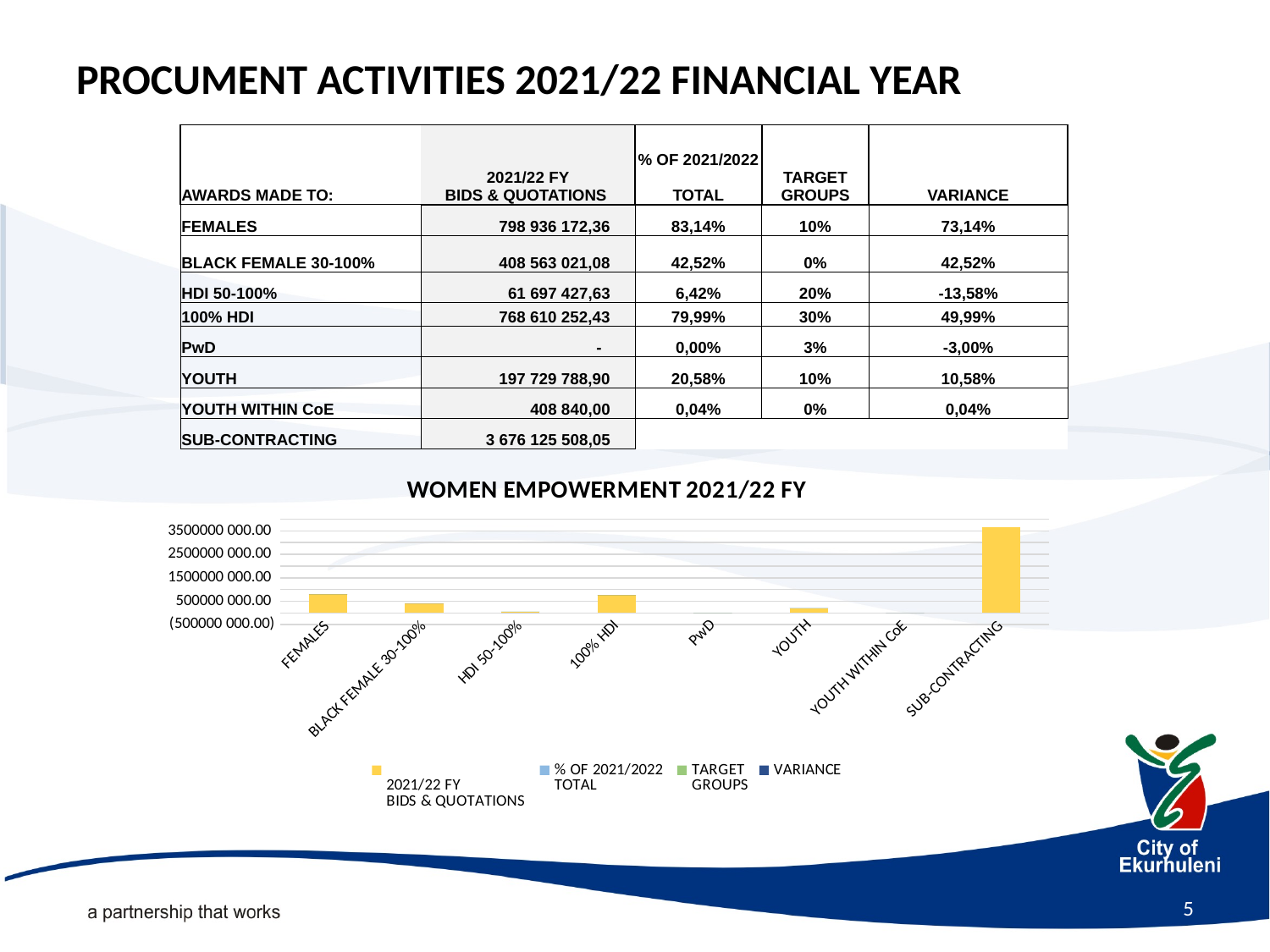
What kind of chart is shown under the title WOMEN EMPOWERMENT 2021/22 FY? Bar chart How many series does the legend of the WOMEN EMPOWERMENT 2021/22 FY chart list? 4 In the WOMEN EMPOWERMENT 2021/22 FY chart, which category has the tallest bar? SUB-CONTRACTING In the WOMEN EMPOWERMENT 2021/22 FY chart, is the bar for FEMALES greater or less than 500000 000.00? greater In the WOMEN EMPOWERMENT 2021/22 FY chart, which bar is taller: YOUTH or YOUTH WITHIN CoE? YOUTH In the WOMEN EMPOWERMENT 2021/22 FY chart, which bar is taller: FEMALES or BLACK FEMALE 30-100%? FEMALES According to the table on the slide, what is the 2021/22 FY BIDS & QUOTATIONS value for SUB-CONTRACTING? 3 676 125 508,05 According to the table on the slide, what is the 2021/22 FY BIDS & QUOTATIONS value for FEMALES? 798 936 172,36 What is the title of the chart on the slide? WOMEN EMPOWERMENT 2021/22 FY In the WOMEN EMPOWERMENT 2021/22 FY chart, is the bar for SUB-CONTRACTING greater or less than 2500000 000.00? greater In the WOMEN EMPOWERMENT 2021/22 FY chart, is the bar for HDI 50-100% greater or less than 500000 000.00? less How many categories are shown along the x axis of the WOMEN EMPOWERMENT 2021/22 FY chart? 8